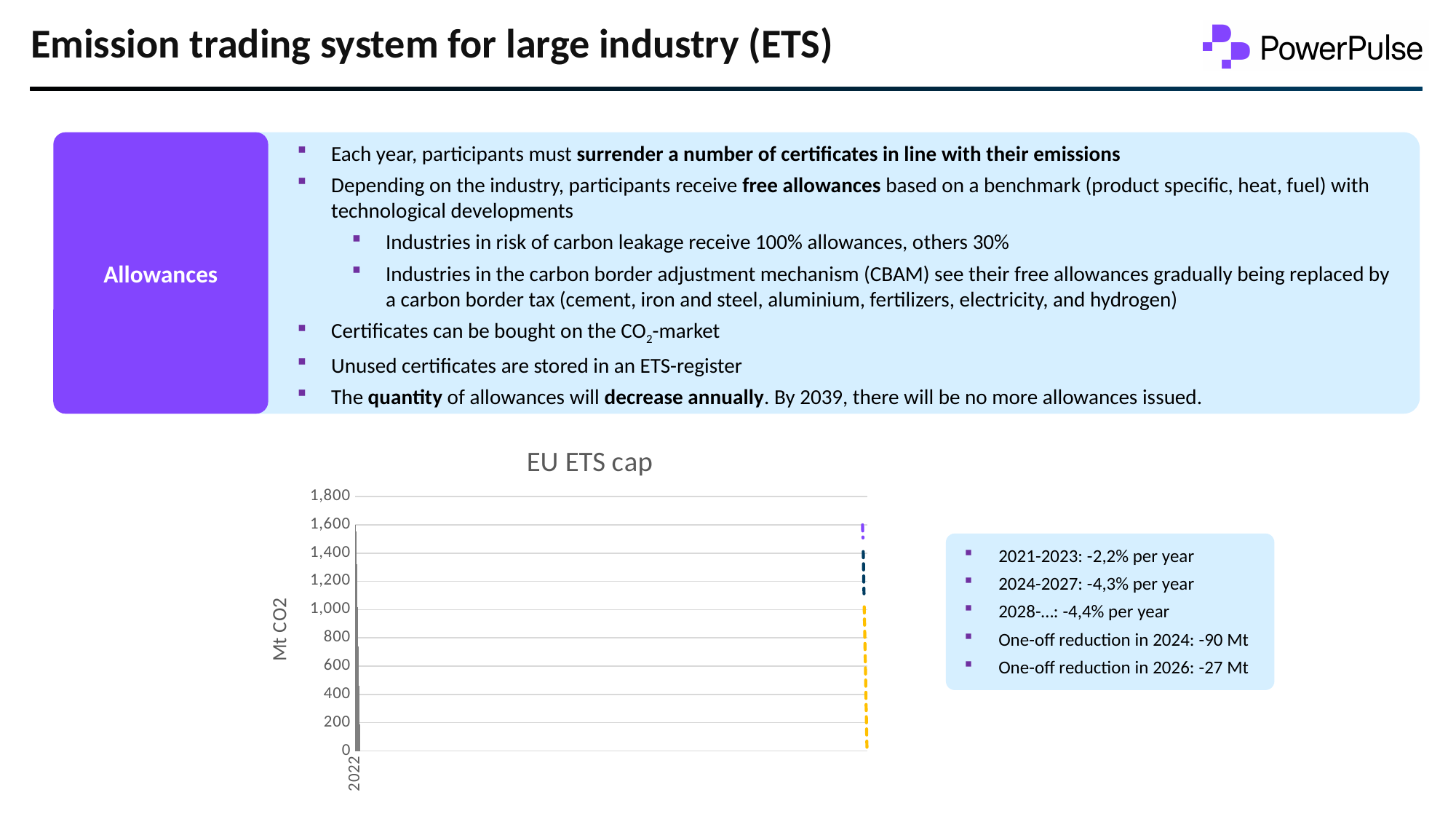
What kind of chart is the EU ETS cap chart? bar chart What is the highest tick value shown on the vertical axis of the EU ETS cap chart? 1,800 In the EU ETS cap chart, is the value for 2022 greater or less than 1,000? greater What is the title of the chart on the slide? EU ETS cap Which year is labelled on the horizontal axis of the EU ETS cap chart? 2022 What is the label on the vertical axis of the EU ETS cap chart? Mt CO2